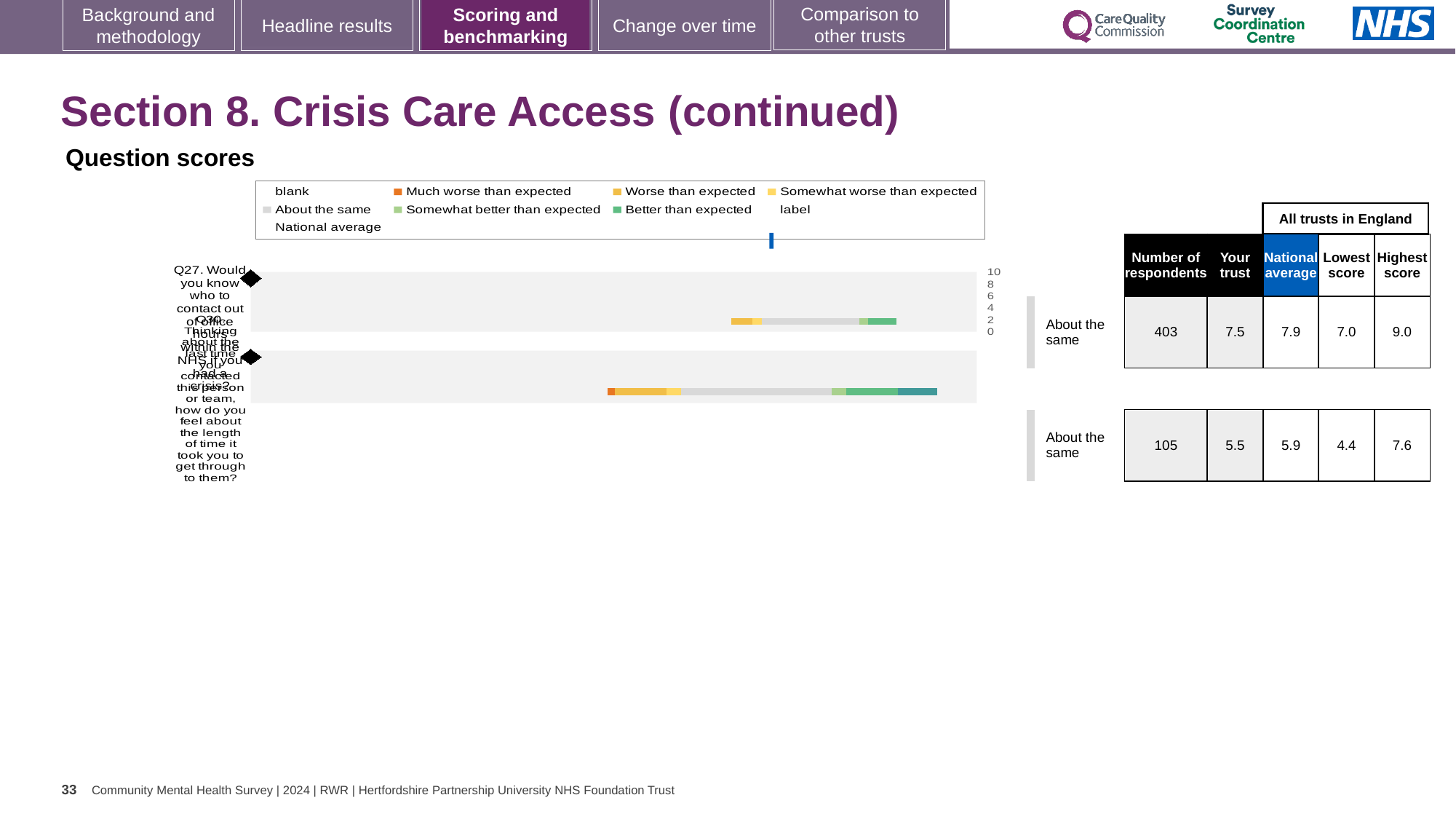
What is the lowest score among all trusts in England for Q27? 7.0 What is the difference between the highest score and the lowest score for Q27? 2.0 How many survey questions are plotted in the Question scores chart? 2 What kind of chart is shown under 'Question scores'? bar chart What benchmark category is shown for Q30? About the same What is the highest score among all trusts in England for Q30? 7.6 What is the 'Your trust' score for Q27 in the table beside the chart? 7.5 Which question has the higher 'Your trust' score, Q27 or Q30? Q27 What is the national average score for Q30? 5.9 How many respondents answered Q27? 403 What is the maximum value shown on the chart's score axis? 10 By how much does the national average exceed the 'Your trust' score for Q30? 0.4